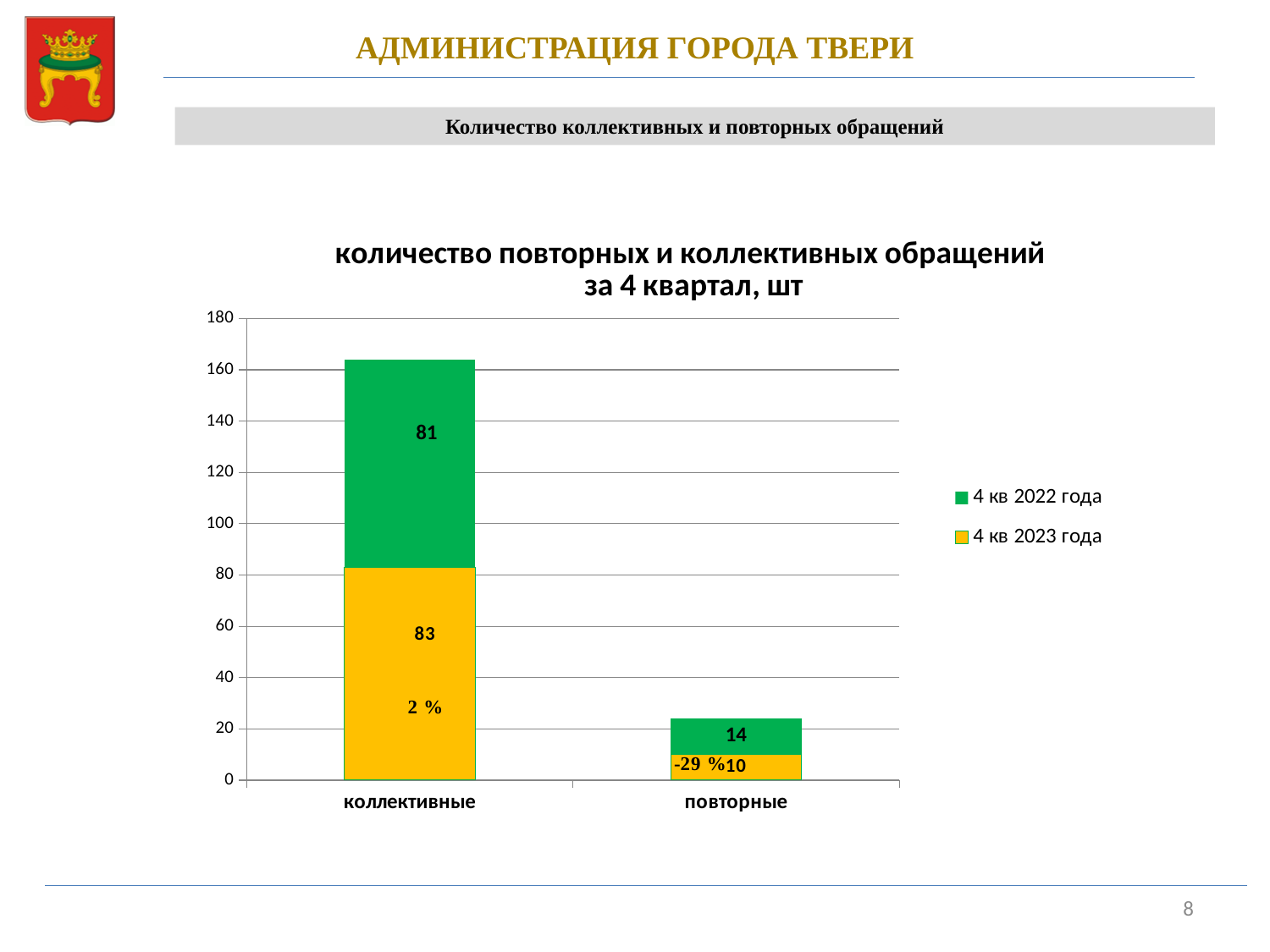
What kind of chart is shown on the slide? stacked bar chart How many categories are shown on the x axis? 2 How many series does the legend list? 2 What is the total of the stacked bar for повторные? 24 What is the total of the stacked bar for коллективные? 164 What is the value for коллективные in the 4 кв 2023 года series? 83 Which category has the highest total stacked bar? коллективные Which is larger for коллективные: the 4 кв 2022 года value or the 4 кв 2023 года value? 4 кв 2023 года What is the value for повторные in the 4 кв 2023 года series? 10 What is the difference between the 4 кв 2022 года and 4 кв 2023 года values for повторные? 4 What is the value for коллективные in the 4 кв 2022 года series? 81 What is the value for повторные in the 4 кв 2022 года series? 14